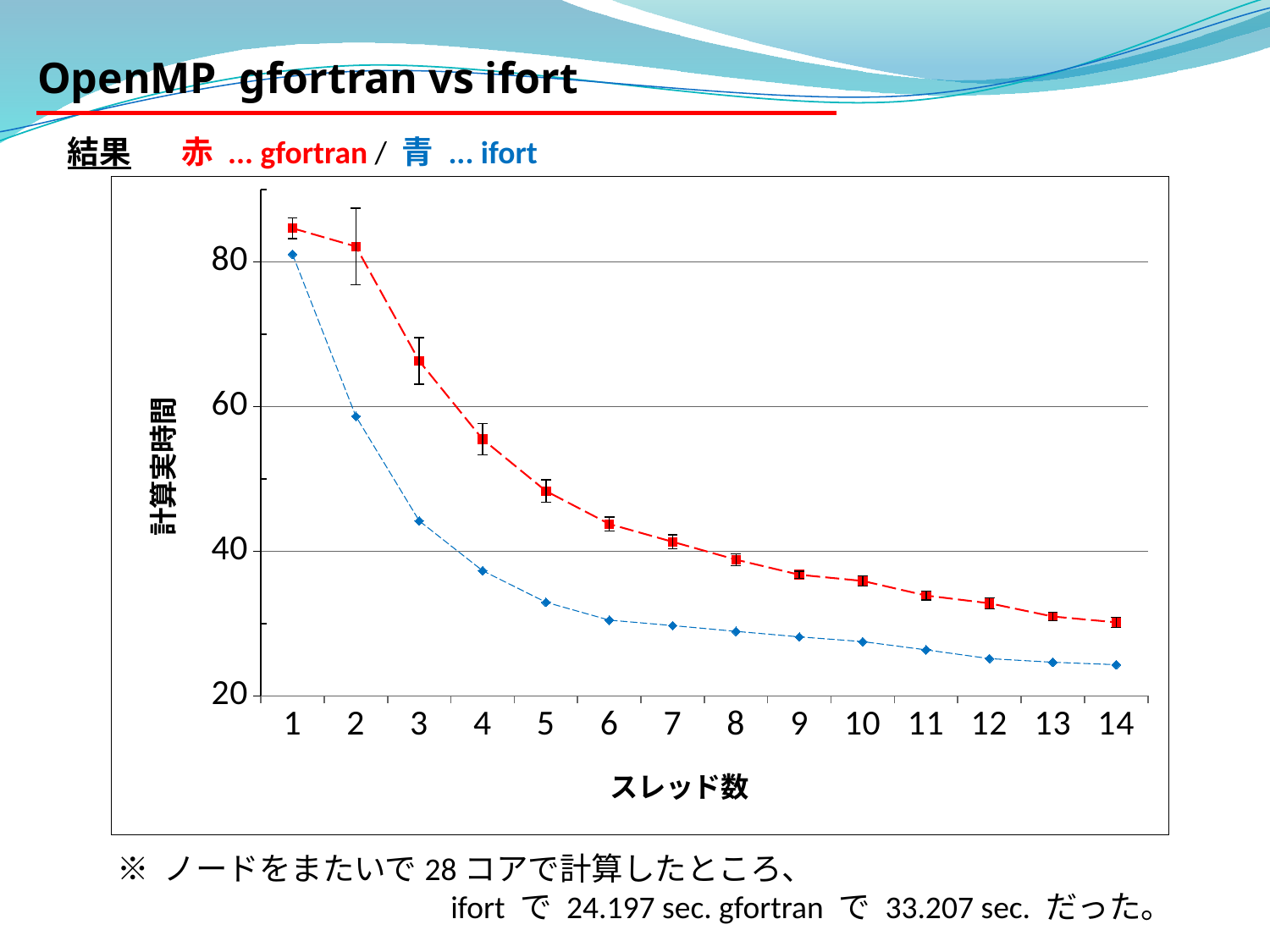
What kind of chart is shown on the slide? line chart How many thread-count values are plotted along the x axis? 14 At which thread count is the ifort (blue) computation time lowest? 14 At which thread count is the gfortran (red) computation time highest? 1 At 3 threads, which compiler has the larger computation time, gfortran or ifort? gfortran Is the ifort (blue) value at 14 threads greater or less than 40? less How many series are plotted on the chart? 2 Is the ifort (blue) value at 3 threads greater or less than 40? greater Do the computation times rise or fall as the number of threads increases? fall What is the label of the x axis? スレッド数 Is the gfortran (red) value at 1 thread greater or less than 80? greater